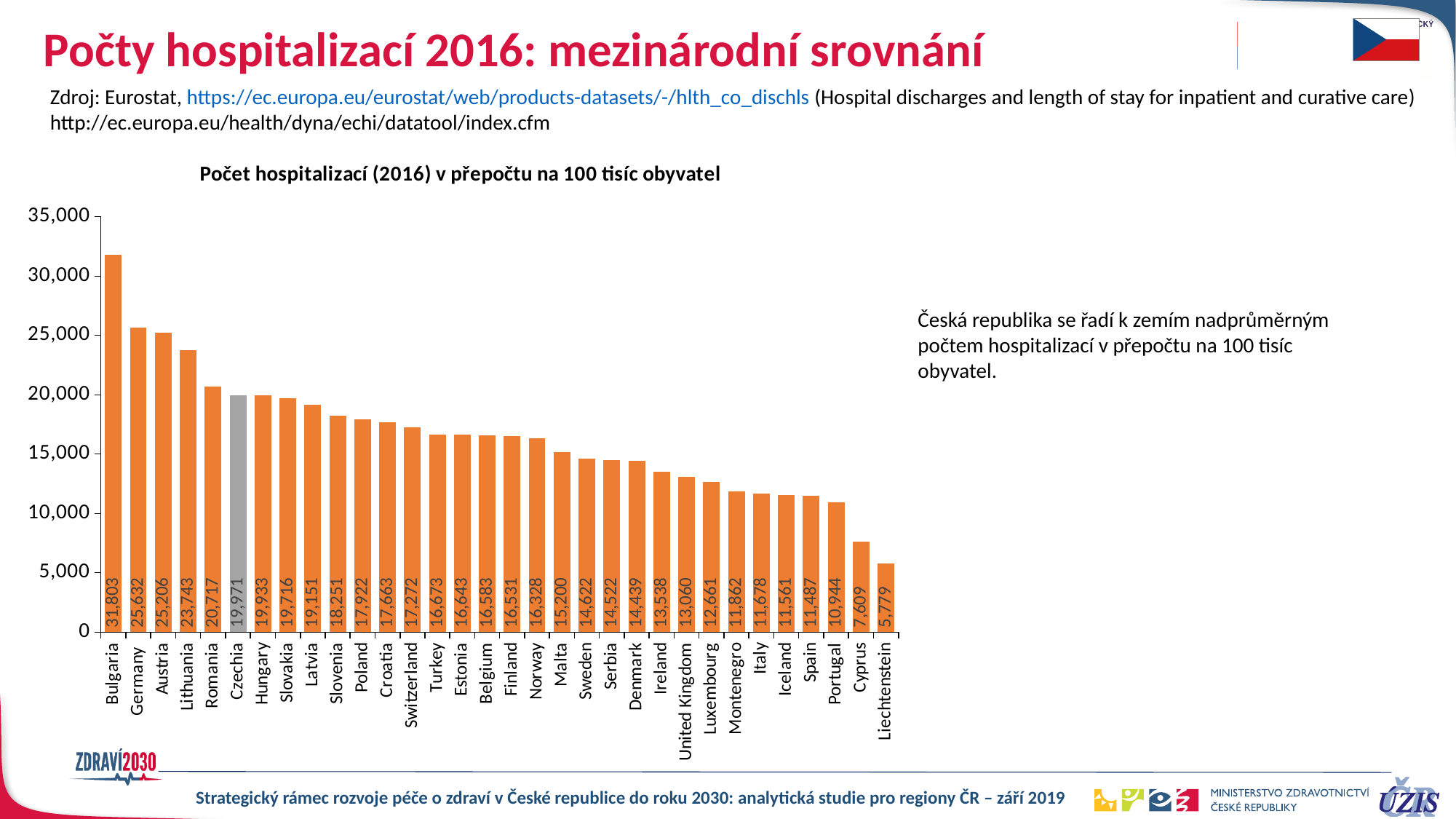
Which country's bar is coloured grey instead of orange? Czechia Which has a larger value, Austria or Lithuania? Austria Which country has the highest number of hospitalisations per 100 thousand inhabitants? Bulgaria What is the difference between the values for Czechia and Hungary? 38 What is the value for Czechia? 19,971 What kind of chart is shown on the slide? bar chart What is the difference between the values for Bulgaria and Germany? 6,171 What is the value for Bulgaria? 31,803 Is the value for Cyprus greater or less than 10,000? less How many countries are shown in the chart? 32 Which country has the lowest value in the chart? Liechtenstein What is the value for Portugal? 10,944